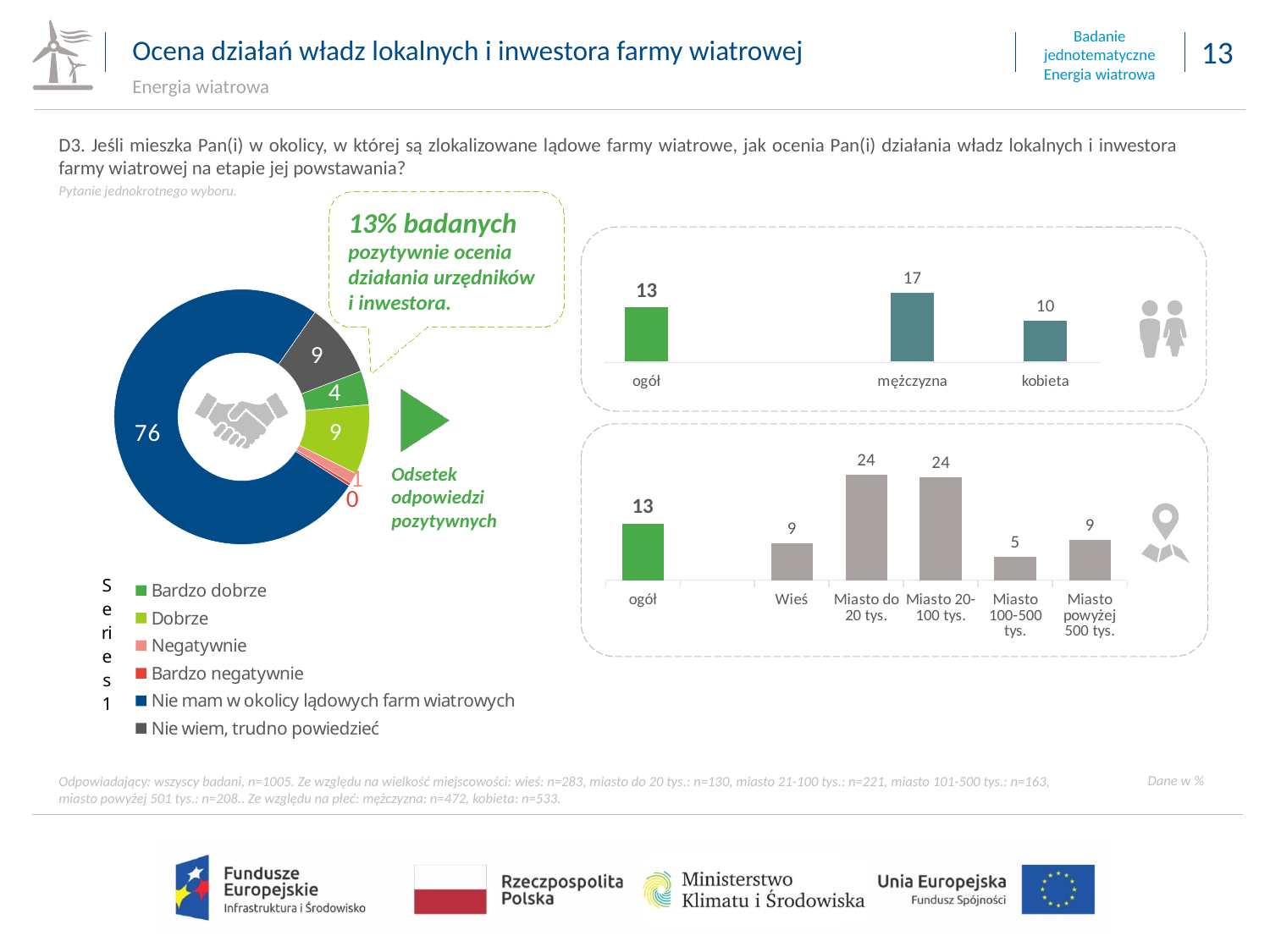
In the top-right bar chart (by gender), what is the value for kobieta? 10 In the bottom-right bar chart (by locality size), which category has the lowest value? Miasto 100-500 tys. In the bottom-right bar chart (by locality size), what is the value for Wieś? 9 In the top-right bar chart (by gender), what is the difference between the values for mężczyzna and kobieta? 7 In the bottom-right bar chart (by locality size), how many categories are shown? 6 What type of chart is shown in the top-right panel (by gender)? bar chart How many entries does the legend of the donut chart on the left list? 6 In the top-right bar chart (by gender), which category has the highest value? mężczyzna In the bottom-right bar chart (by locality size), what is the difference between the values for Miasto 20-100 tys. and Miasto 100-500 tys.? 19 In the donut chart on the left, what is the value for the largest segment? 76 In the bottom-right bar chart (by locality size), is the value for Miasto do 20 tys. larger or smaller than the value for ogół? larger In the top-right bar chart (by gender), what is the value for mężczyzna? 17